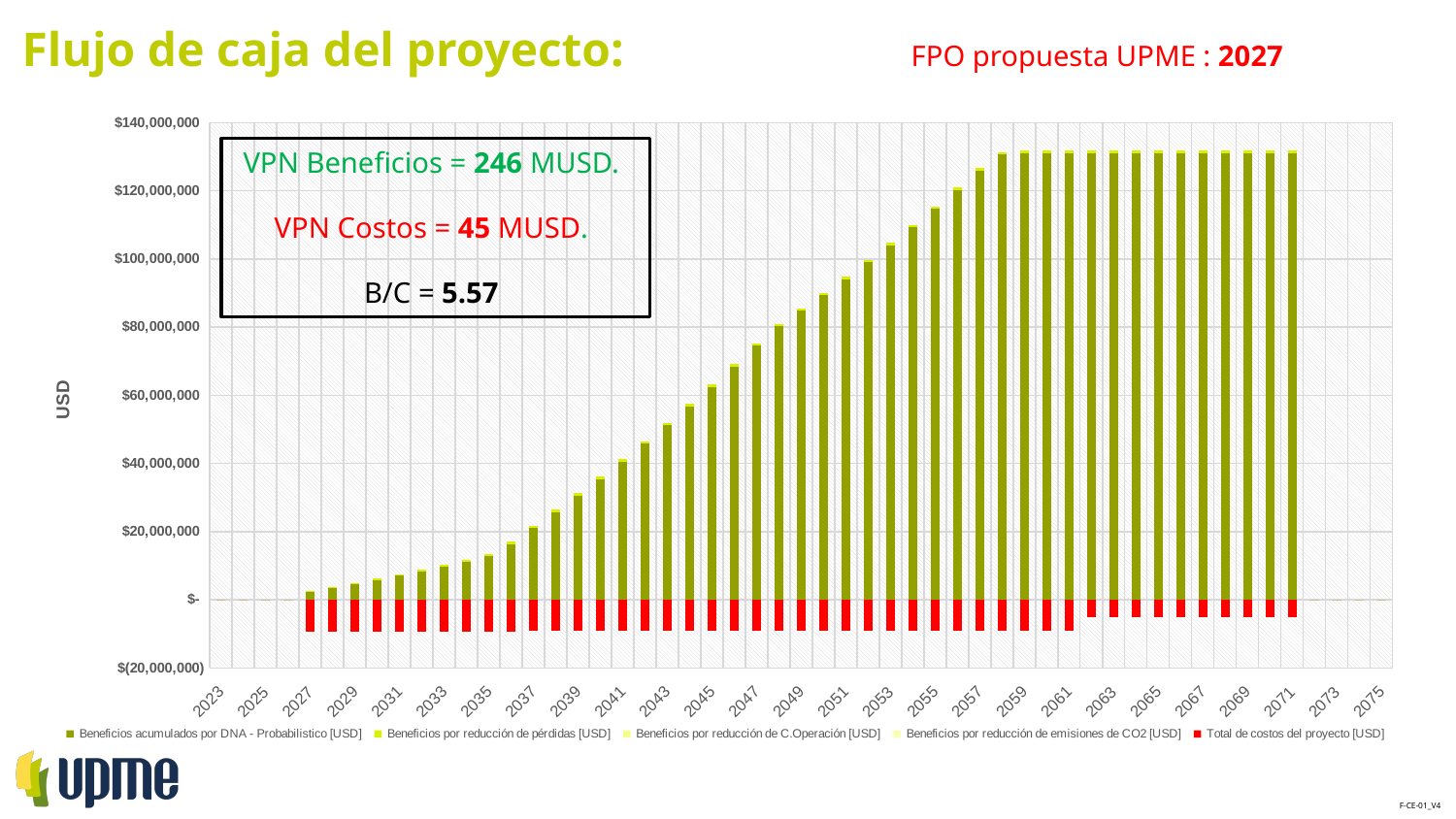
Is the value of the green benefit bar for 2071 greater or less than $120,000,000? greater How many series does the chart legend list? 5 Which year has the lowest green benefit bar among the years with bars? 2027 Do the green benefit bars rise or fall from 2027 to 2057 along the x axis? rise In which year do the bars first appear on the chart? 2027 Which year has the larger green benefit bar, 2039 or 2049? 2049 What is the title of the slide containing the chart? Flujo de caja del proyecto: Is the value of the red 'Total de costos del proyecto' bar for 2027 greater or less than $-? less Is the value of the green benefit bar for 2055 greater or less than $100,000,000? greater What kind of chart is shown on the slide? bar chart